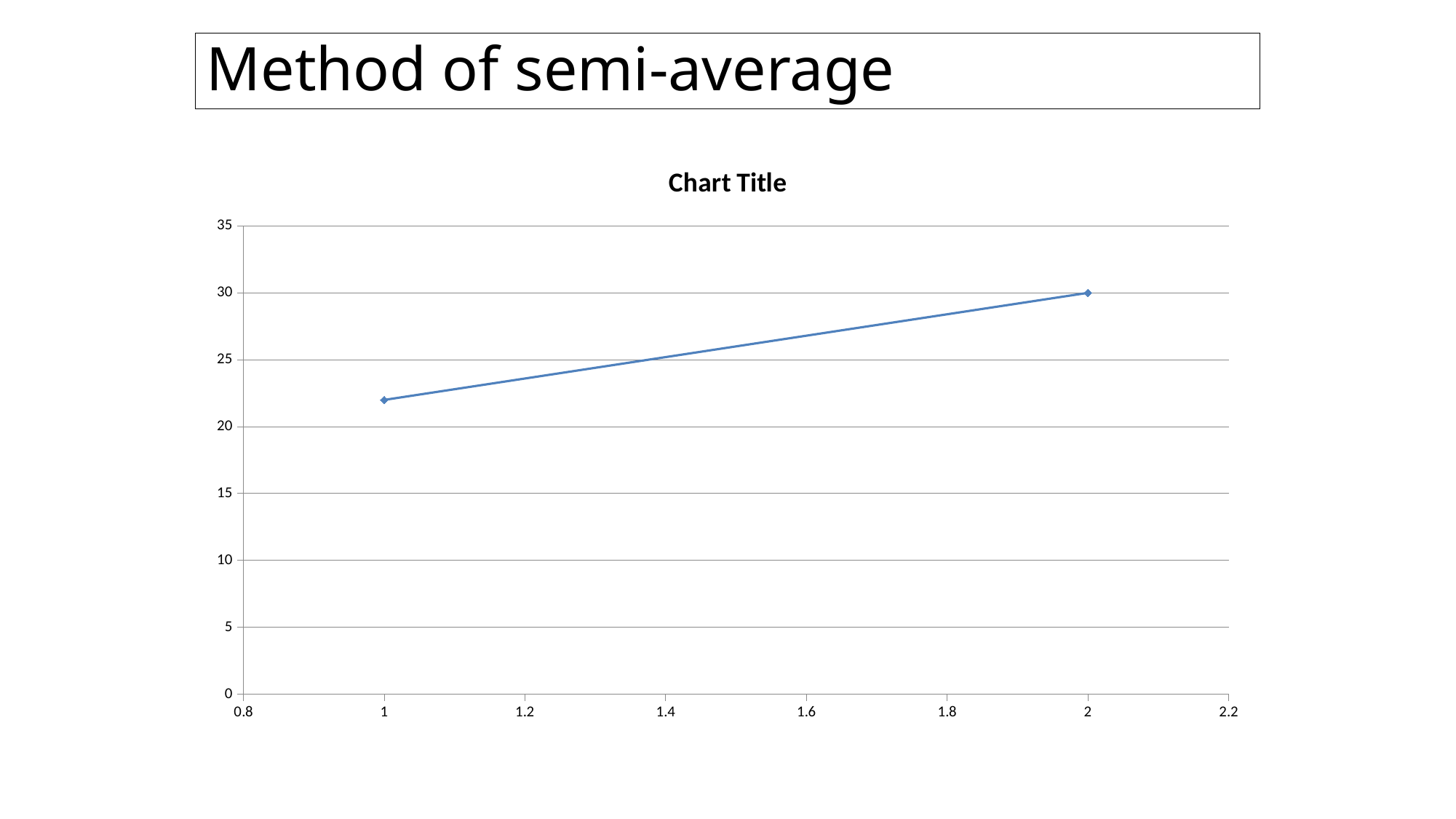
At which x value is the plotted value lowest? 1 At which x value is the plotted value highest? 2 Which x value has the higher plotted value, 1 or 2? 2 How many data points are plotted on the chart? 2 Is the value plotted at x = 2 greater or less than 25? greater What is the value plotted at x = 2? 30 Do the plotted values rise or fall as x increases from 1 to 2? rise Is the value plotted at x = 1 greater or less than 25? less What is the highest value labelled on the vertical axis? 35 What kind of chart is shown on the slide? line chart Is the value plotted at x = 1 greater or less than 20? greater What is the title shown above the chart? Chart Title